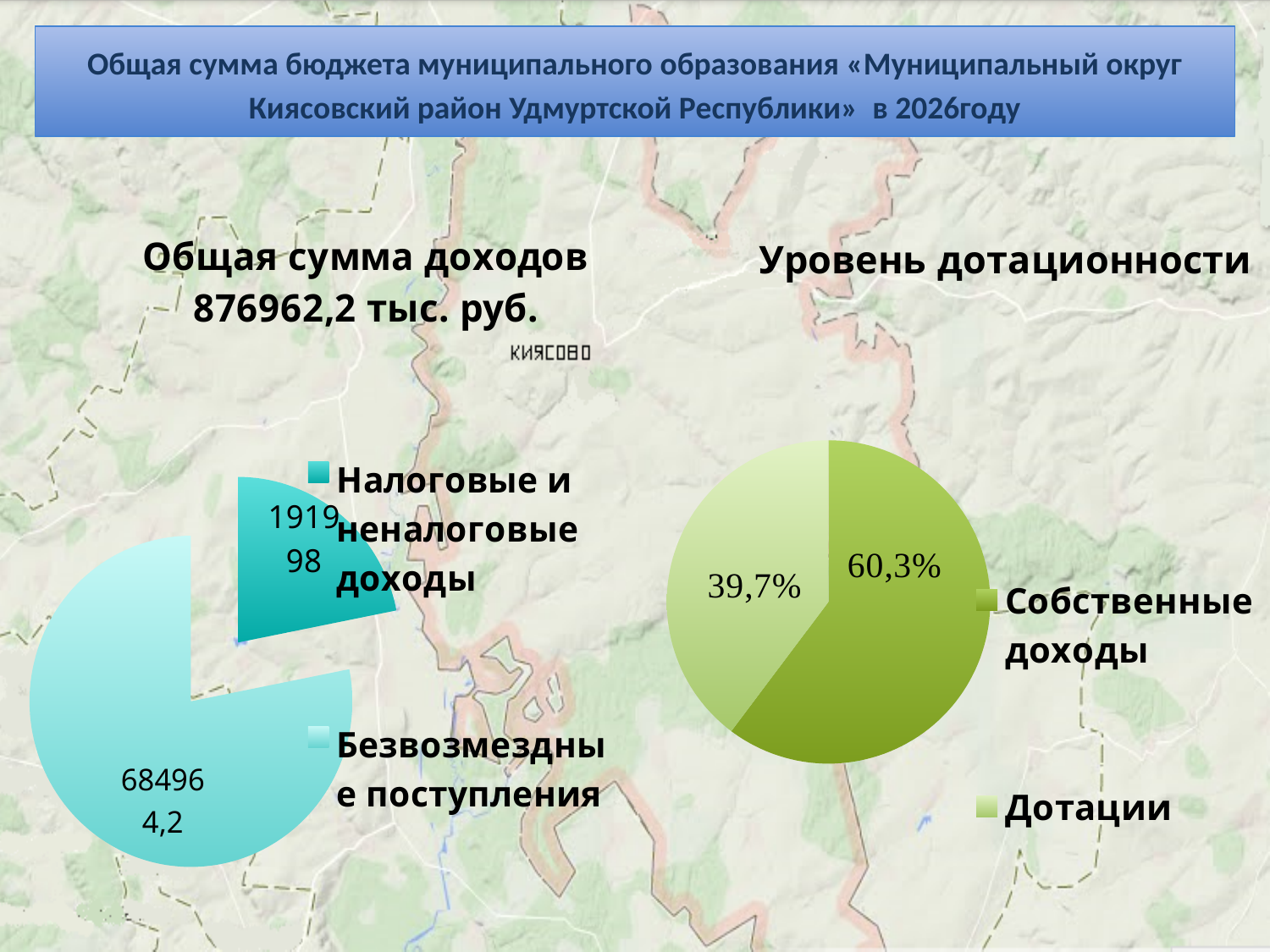
In the right chart "Уровень дотационности", what is the value for "Собственные доходы"? 60,3% In the left chart "Общая сумма доходов", what is the difference between "Безвозмездные поступления" and "Налоговые и неналоговые доходы"? 492966,2 What kind of chart is the right chart titled "Уровень дотационности"? pie chart In the right chart "Уровень дотационности", which is larger: "Собственные доходы" or "Дотации"? Собственные доходы In the right chart "Уровень дотационности", what is the value for "Дотации"? 39,7% In the right chart "Уровень дотационности", which category has the smallest slice? Дотации How many categories does the legend of the left chart "Общая сумма доходов" list? 2 In the left chart "Общая сумма доходов", which category has the largest slice? Безвозмездные поступления In the right chart "Уровень дотационности", what is the difference between "Собственные доходы" and "Дотации"? 20,6% In the left chart "Общая сумма доходов", what is the value for "Безвозмездные поступления"? 684964,2 In the left chart "Общая сумма доходов", what is the value for "Налоговые и неналоговые доходы"? 191998 What kind of chart is the left chart titled "Общая сумма доходов 876962,2 тыс. руб."? pie chart